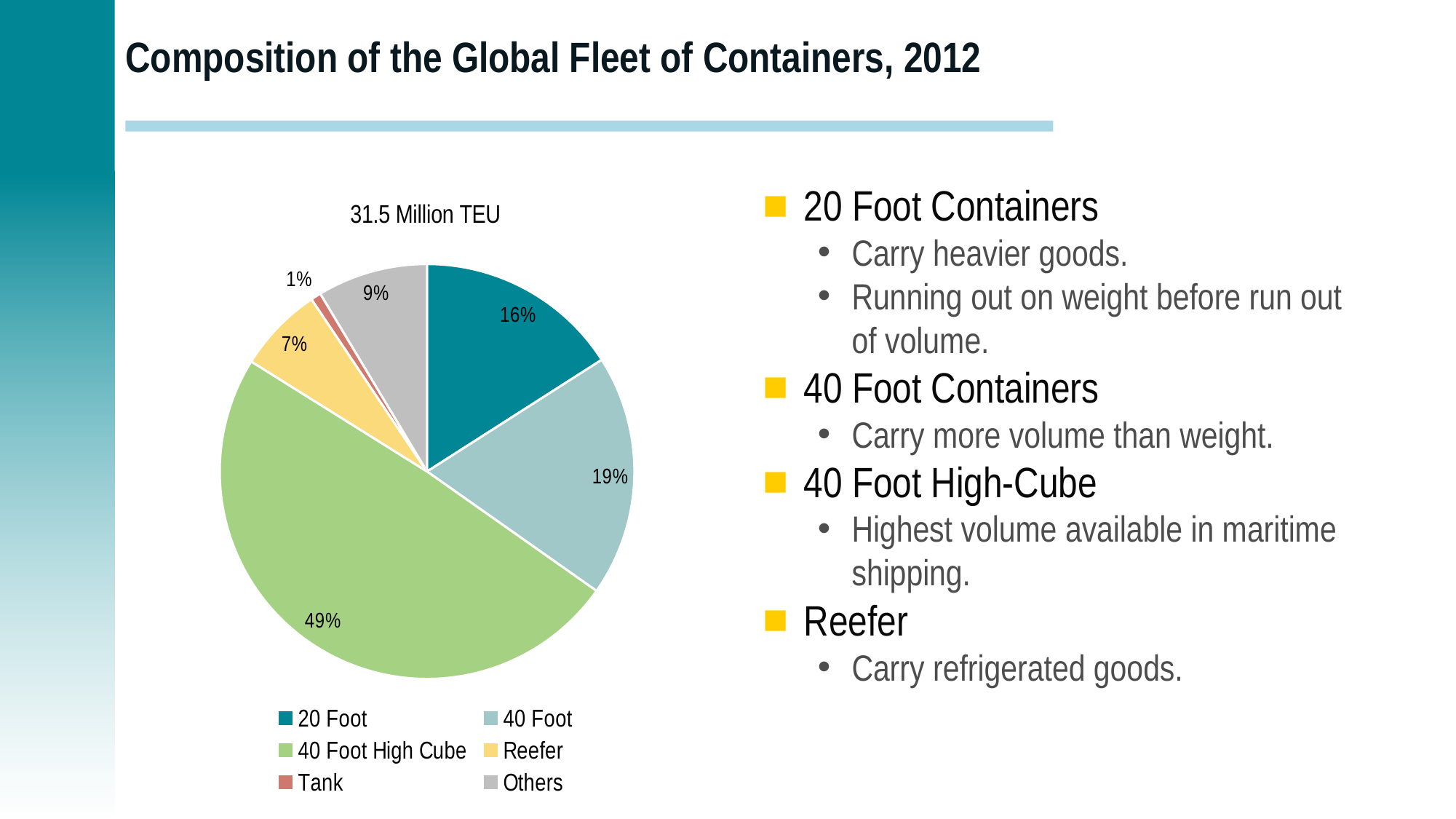
Which container type has the largest share of the fleet? 40 Foot High Cube What share of the global container fleet is 20 Foot containers? 16% What is the chart's title above the pie? 31.5 Million TEU What share of the global container fleet is 40 Foot containers? 19% Which container type has the smallest share of the fleet? Tank How many percentage points larger is the 40 Foot share than the 20 Foot share? 3 Which has a larger share of the fleet, Others or Reefer? Others What share of the global container fleet is 40 Foot High Cube containers? 49% What type of chart is shown on the slide? Pie chart How many container categories does the pie chart show? 6